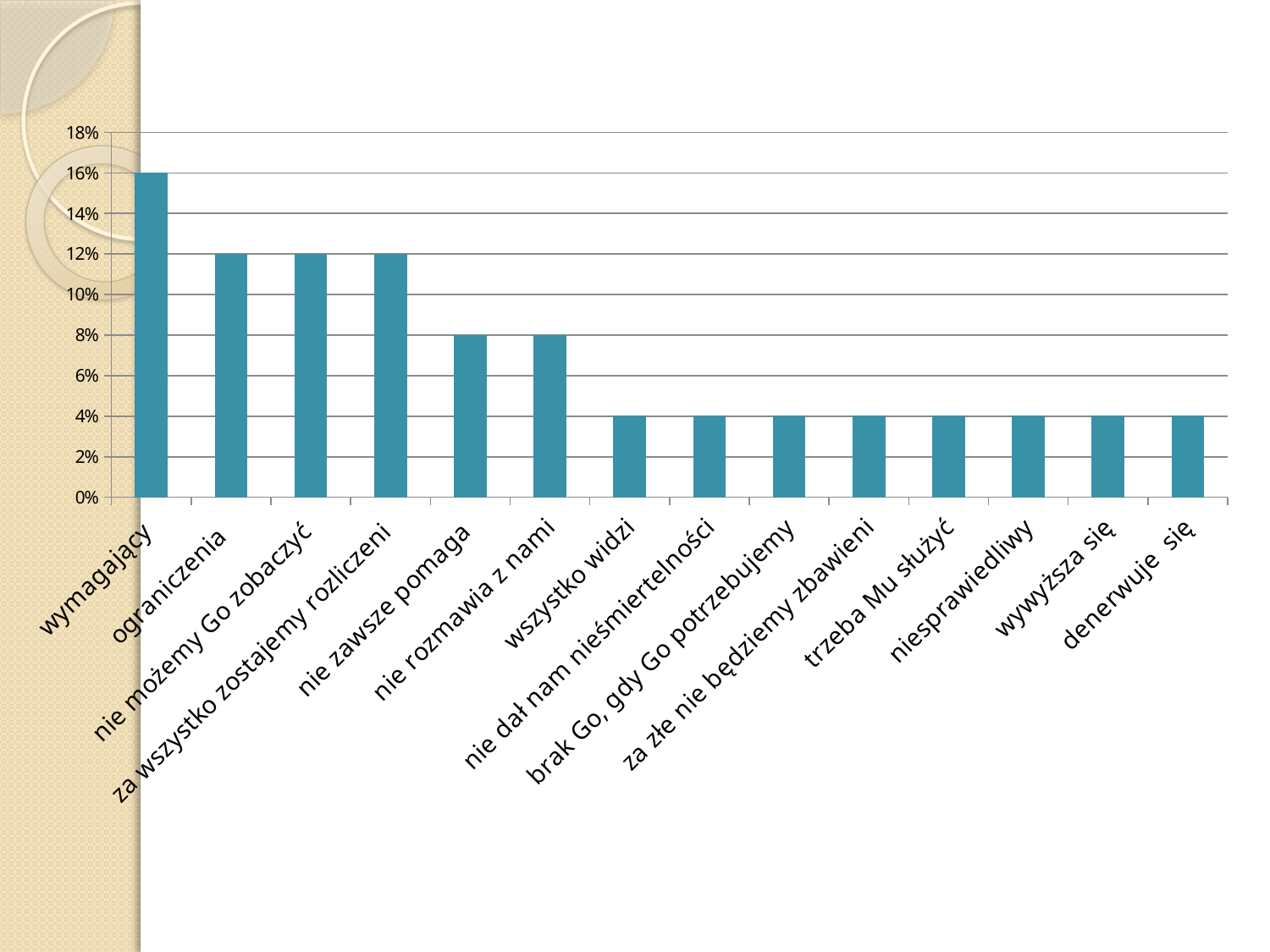
How many categories are shown on the x axis? 14 Do the values rise or fall from left to right along the x axis? fall Which category has the highest value? wymagający What is the value for "nie zawsze pomaga"? 8% What is the difference between the values for "ograniczenia" and "wszystko widzi"? 8% What is the difference between the values for "wymagający" and "nie rozmawia z nami"? 8% What is the value for "ograniczenia"? 12% Is the value for "wymagający" greater or less than 10%? greater What is the value for "niesprawiedliwy"? 4% What is the value for "wymagający"? 16% Which is larger, the value for "za wszystko zostajemy rozliczeni" or the value for "trzeba Mu służyć"? za wszystko zostajemy rozliczeni What kind of chart is shown on the slide? bar chart